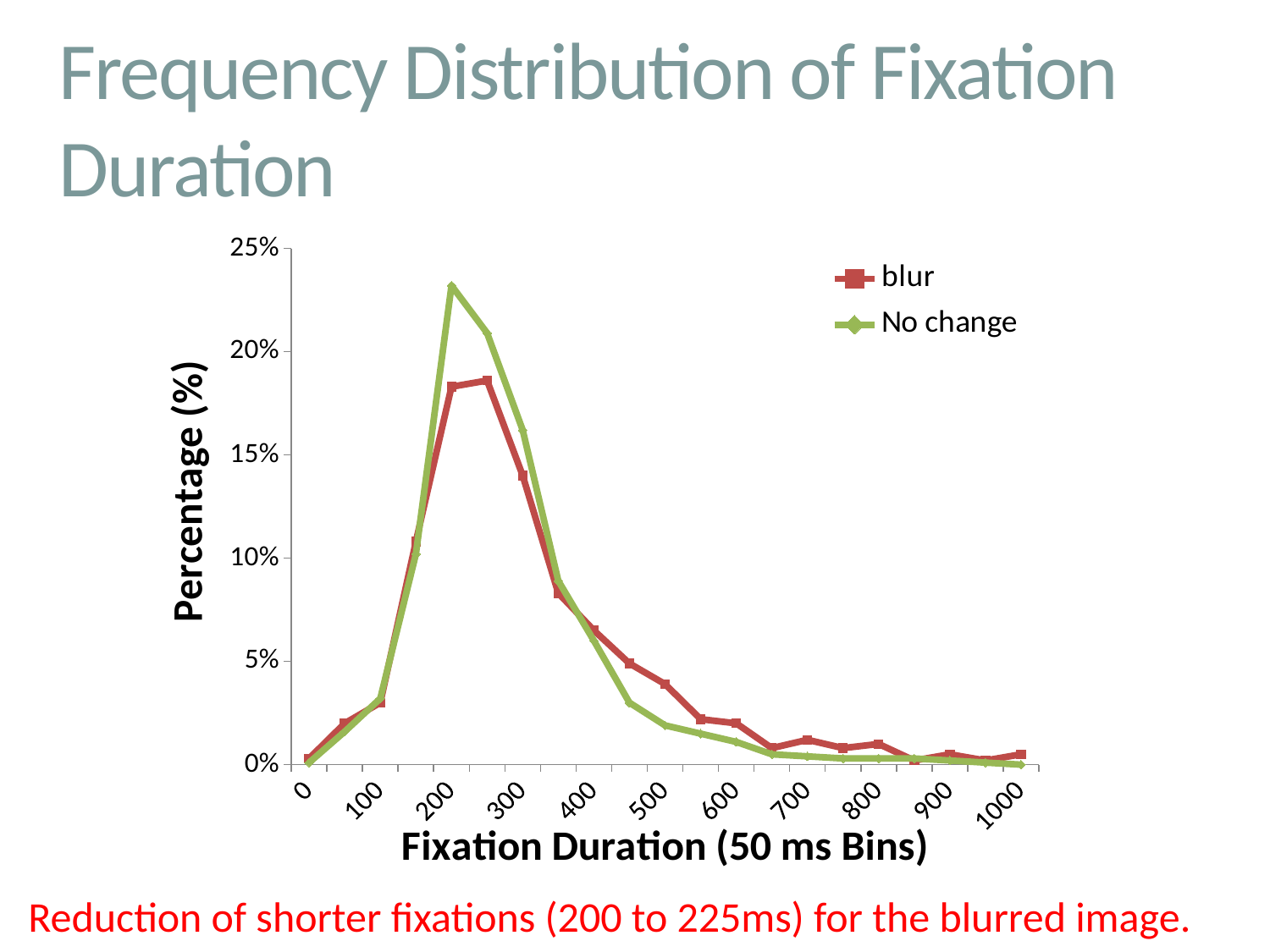
Is the value for the blur series at a fixation duration of 200 greater or less than 20%? less Is the value for the No change series at a fixation duration of 200 greater or less than 20%? greater What is the title of the vertical axis? Percentage (%) Is the value for the blur series at a fixation duration of 300 greater or less than 15%? less From a fixation duration of 300 to 1000, do the values for the No change series rise or fall? fall At a fixation duration of 500, which series has the higher value, blur or No change? blur At a fixation duration of 200, which series has the higher value, blur or No change? No change What kind of chart is shown on the slide? line chart How many series does the legend list? 2 What are the two series named in the legend? blur and No change Which series reaches the highest peak value on the chart? No change